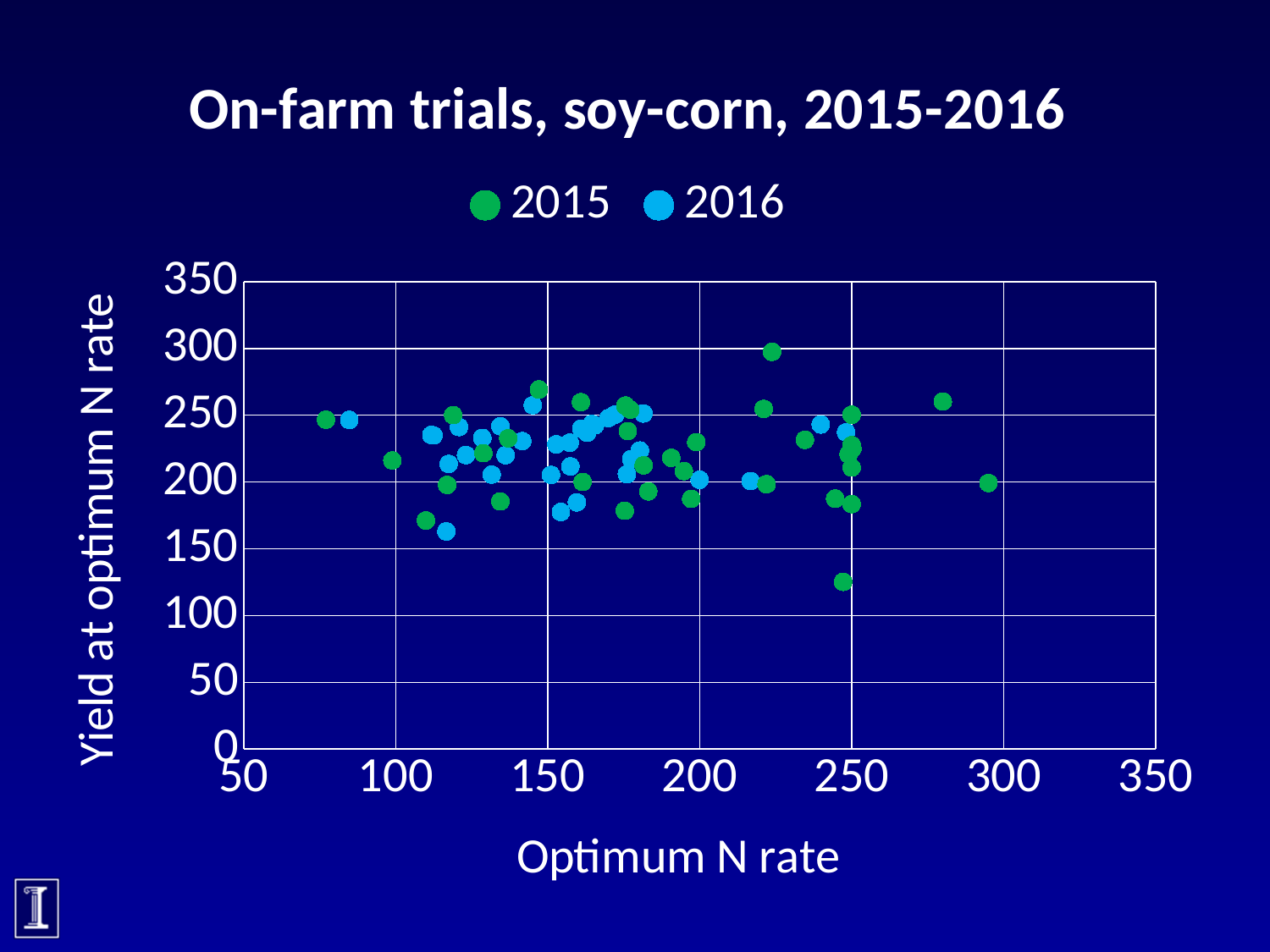
What is the label of the vertical axis? Yield at optimum N rate What is the title of the chart? On-farm trials, soy-corn, 2015-2016 What are the two series named in the legend? 2015 and 2016 What is the maximum value shown on the vertical axis? 350 Which series contains the point with the lowest yield? 2015 Is the yield of the highest point on the chart greater or less than 250? greater Which series contains the point with the highest yield? 2015 How many series does the legend list? 2 What is the minimum value shown on the horizontal axis? 50 What kind of chart is shown on the slide? Scatter chart What is the label of the horizontal axis? Optimum N rate Is the yield of the lowest point on the chart greater or less than 150? less